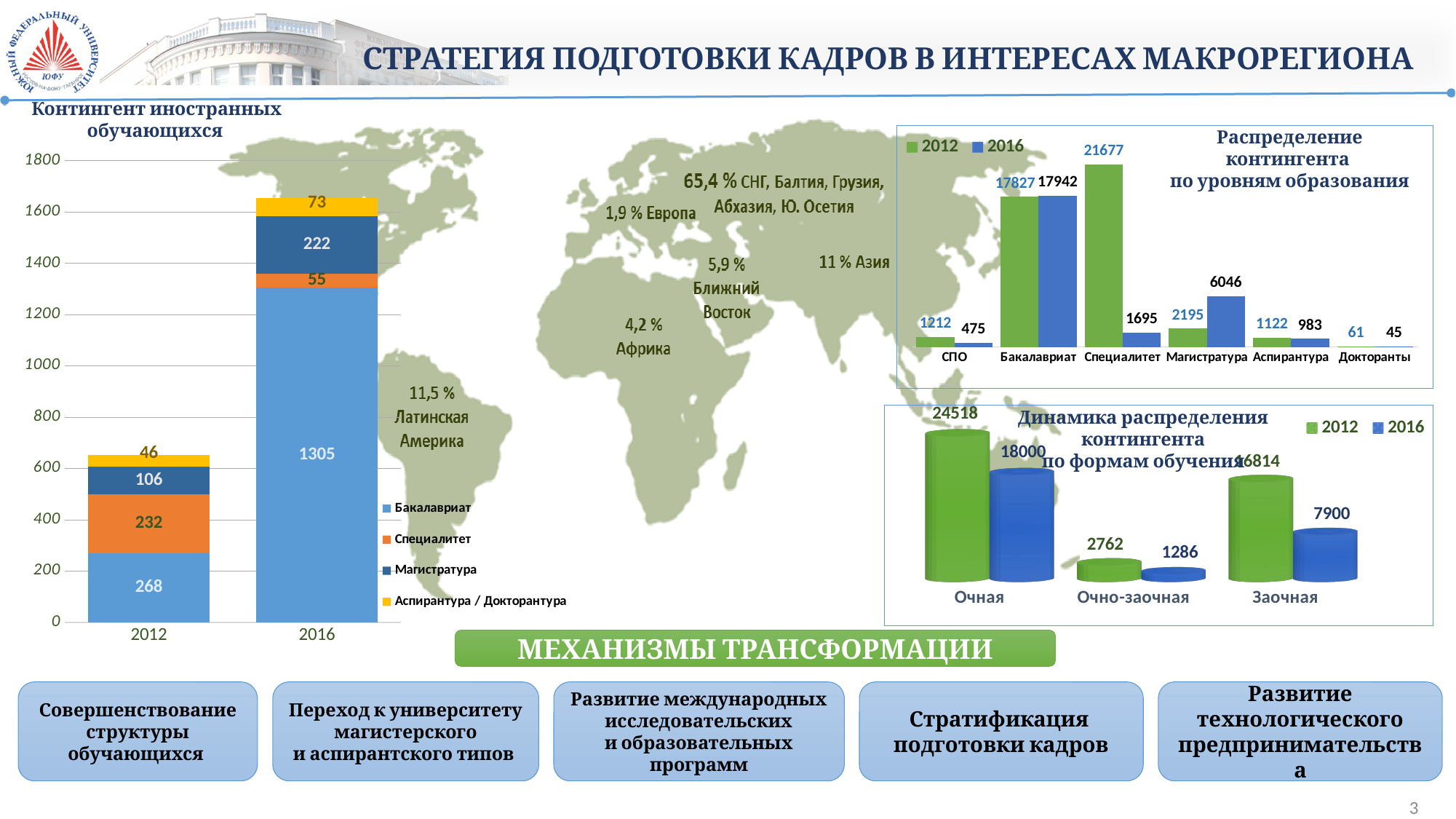
In the chart 'Контингент иностранных обучающихся', what is the difference between the Специалитет values for 2012 and 2016? 177 What kind of chart is 'Динамика распределения контингента по формам обучения'? Bar chart In the chart 'Распределение контингента по уровням образования', which category has the lowest 2016 value? Докторанты In the chart 'Динамика распределения контингента по формам обучения', what is the difference between the 2012 and 2016 values for Очная? 6518 In the chart 'Контингент иностранных обучающихся', what is the value for Бакалавриат in 2016? 1305 In the chart 'Контингент иностранных обучающихся', how many series does the legend list? 4 In the chart 'Контингент иностранных обучающихся', what is the total of the stacked bar for 2012? 652 In the chart 'Распределение контингента по уровням образования', how many categories are shown on the x axis? 6 In the chart 'Распределение контингента по уровням образования', what is the 2012 value for Специалитет? 21677 In the chart 'Динамика распределения контингента по формам обучения', which category has the highest 2012 value? Очная In the chart 'Распределение контингента по уровням образования', which is larger for Магистратура: the 2012 value or the 2016 value? 2016 In the chart 'Динамика распределения контингента по формам обучения', what is the 2016 value for Заочная? 7900